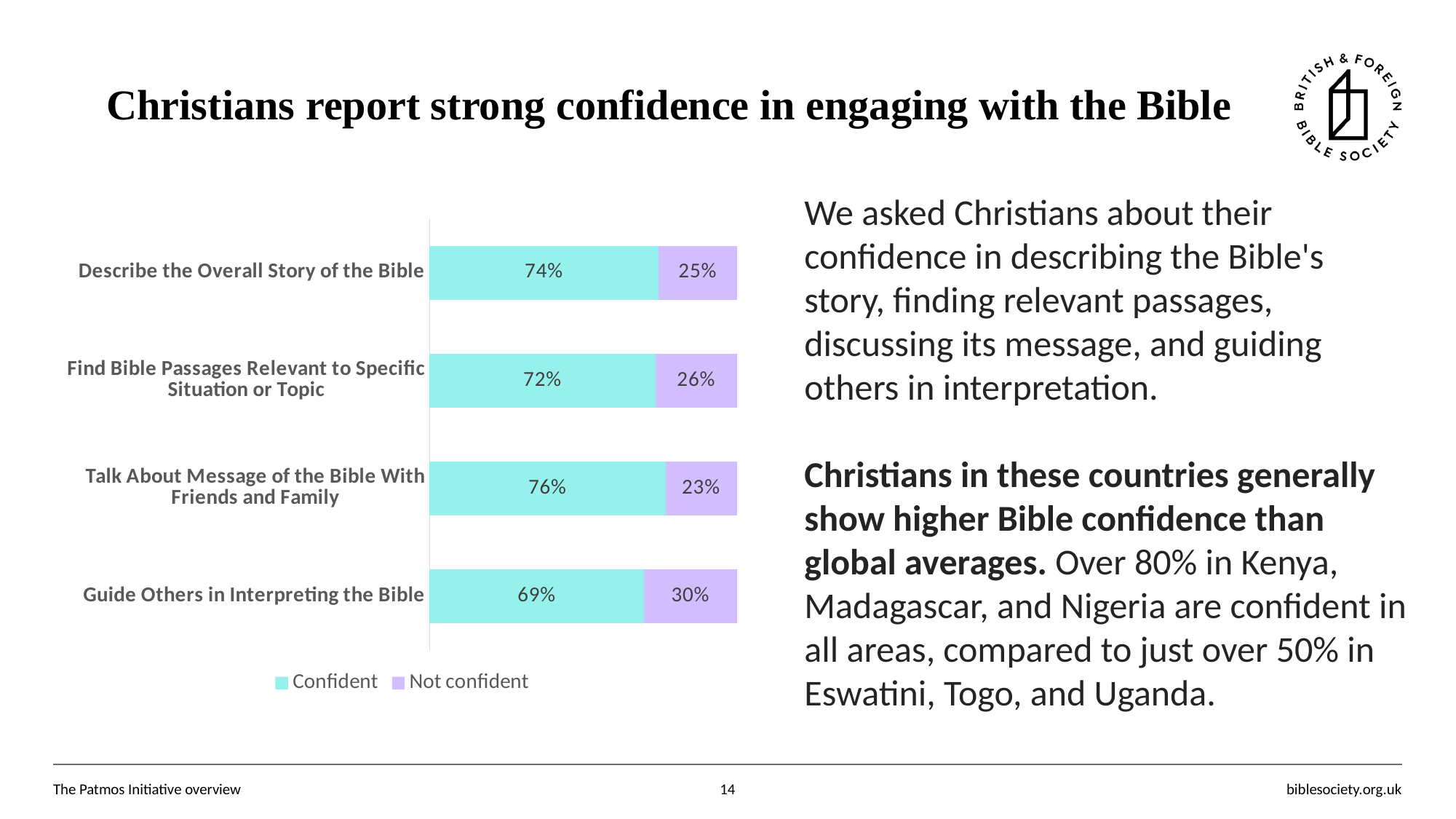
How many series does the legend list? 2 Which category has the lowest 'Confident' value? Guide Others in Interpreting the Bible What is the 'Confident' value for 'Find Bible Passages Relevant to Specific Situation or Topic'? 72% What is the 'Not confident' value for 'Guide Others in Interpreting the Bible'? 30% What is the difference between the 'Confident' values for 'Talk About Message of the Bible With Friends and Family' and 'Guide Others in Interpreting the Bible'? 7% Which is larger: the 'Not confident' value for 'Describe the Overall Story of the Bible' or for 'Talk About Message of the Bible With Friends and Family'? Describe the Overall Story of the Bible How many categories are shown in the chart? 4 Which category has the highest 'Not confident' value? Guide Others in Interpreting the Bible Which category has the highest 'Confident' value? Talk About Message of the Bible With Friends and Family What percentage of Christians are confident in describing the overall story of the Bible? 74% What kind of chart is shown on the slide? Stacked bar chart What are the two series named in the legend? Confident and Not confident